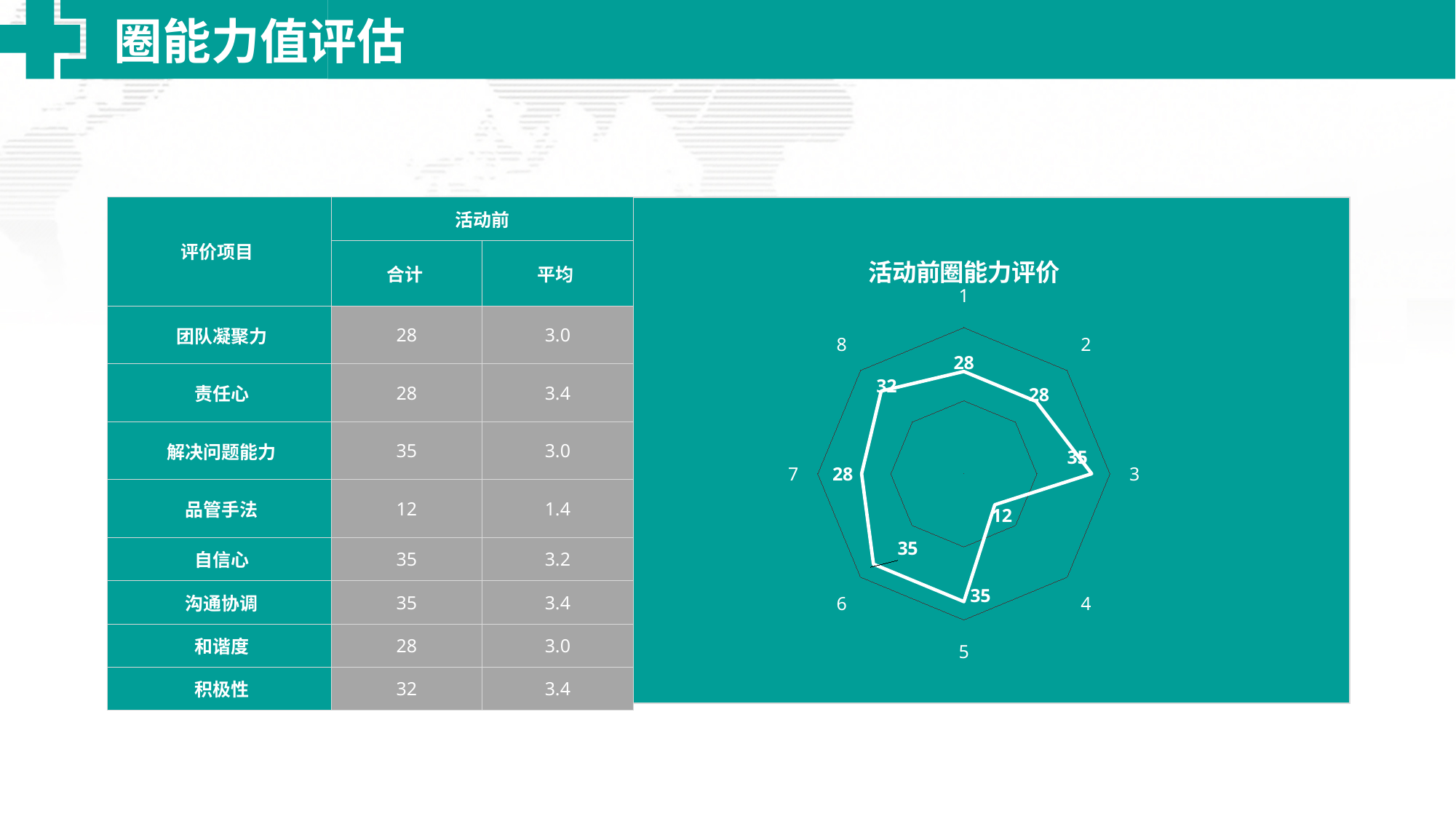
Which is larger, the value for category 5 or the value for category 2? Category 5 How many categories (axes) does the radar chart have? 8 What is the value plotted for category 1 on the radar chart? 28 What is the value plotted for category 4 on the radar chart? 12 What colour is the data line on the radar chart? White What is the value plotted for category 8 on the radar chart? 32 What is the value plotted for category 3 on the radar chart? 35 What is the difference between the values for category 8 and category 7? 4 What kind of chart is shown on the slide? Radar chart What is the title of the chart? 活动前圈能力评价 What is the difference between the values for category 3 and category 4? 23 Which category has the lowest value on the radar chart? 4